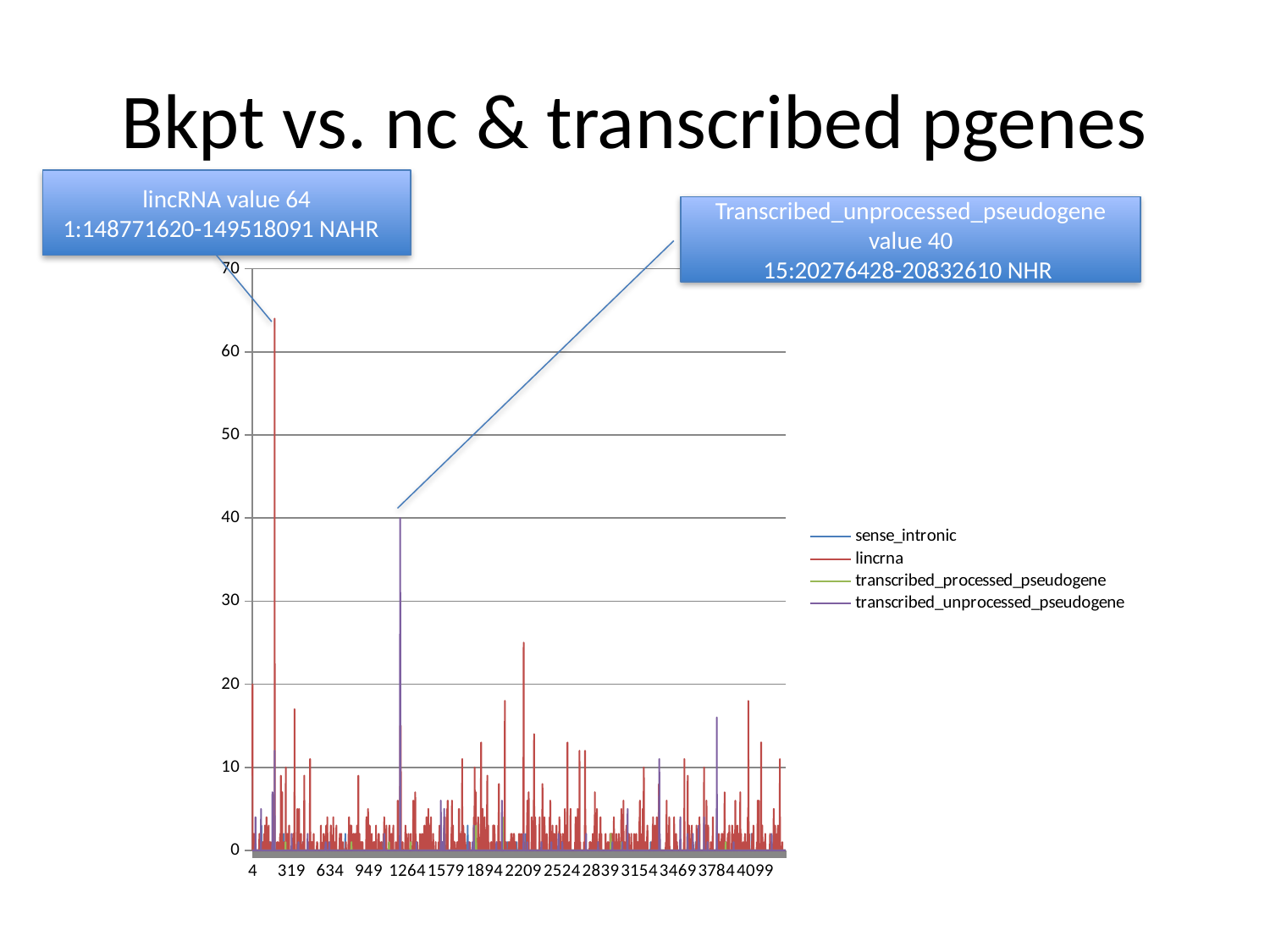
What colour is the lincrna series in the chart? red What is the difference between the lincRNA peak value (64) and the transcribed_unprocessed_pseudogene peak value (40)? 24 What is the title of the slide? Bkpt vs. nc & transcribed pgenes According to the callout, what is the peak value of the lincRNA series? 64 Which series reaches the highest value on the chart? lincrna According to the callout, what is the peak value of the transcribed_unprocessed_pseudogene series? 40 Is the highest transcribed_unprocessed_pseudogene peak greater or less than 50? less What kind of chart is shown on the slide? line chart How many series does the legend list? 4 Which is larger, the lincRNA peak value or the transcribed_unprocessed_pseudogene peak value? lincRNA Is the highest lincrna peak greater or less than 60? greater